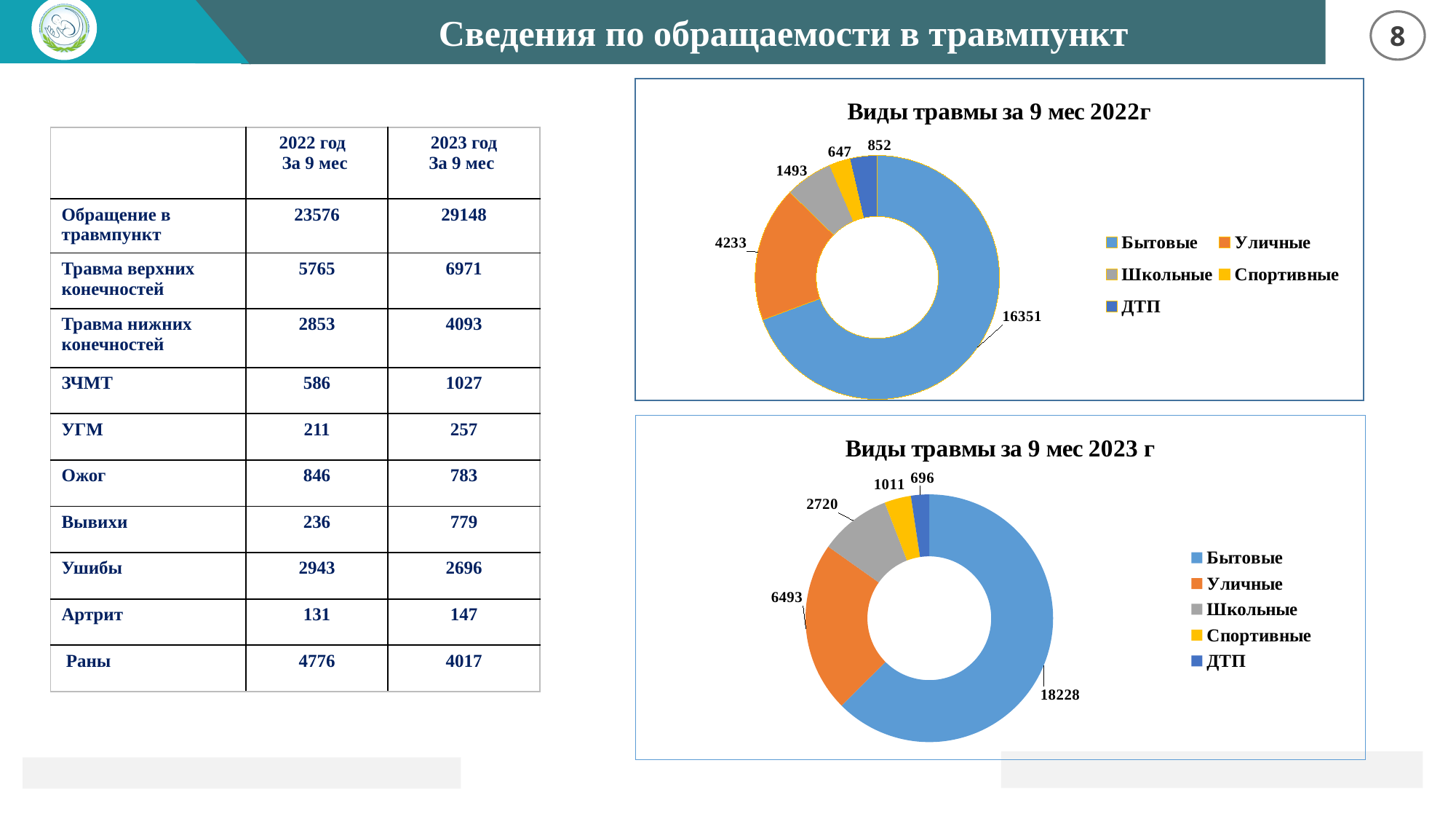
In the chart 'Виды травмы за 9 мес 2023 г', which category has the smallest value? ДТП What type of chart is 'Виды травмы за 9 мес 2022г'? Doughnut chart How many categories does the chart 'Виды травмы за 9 мес 2023 г' show? 5 In the chart 'Виды травмы за 9 мес 2022г', which is larger: Школьные or ДТП? Школьные In the chart 'Виды травмы за 9 мес 2022г', what is the value for Бытовые? 16351 In the chart 'Виды травмы за 9 мес 2023 г', what is the total of all categories? 29148 In the chart 'Виды травмы за 9 мес 2023 г', what is the value for ДТП? 696 In the chart 'Виды травмы за 9 мес 2023 г', what is the value for Школьные? 2720 In the chart 'Виды травмы за 9 мес 2022г', what is the value for Уличные? 4233 In the chart 'Виды травмы за 9 мес 2023 г', what is the difference between Бытовые and Уличные? 11735 In the chart 'Виды травмы за 9 мес 2022г', which category has the largest value? Бытовые In the chart 'Виды травмы за 9 мес 2022г', which category has the smallest value? Спортивные